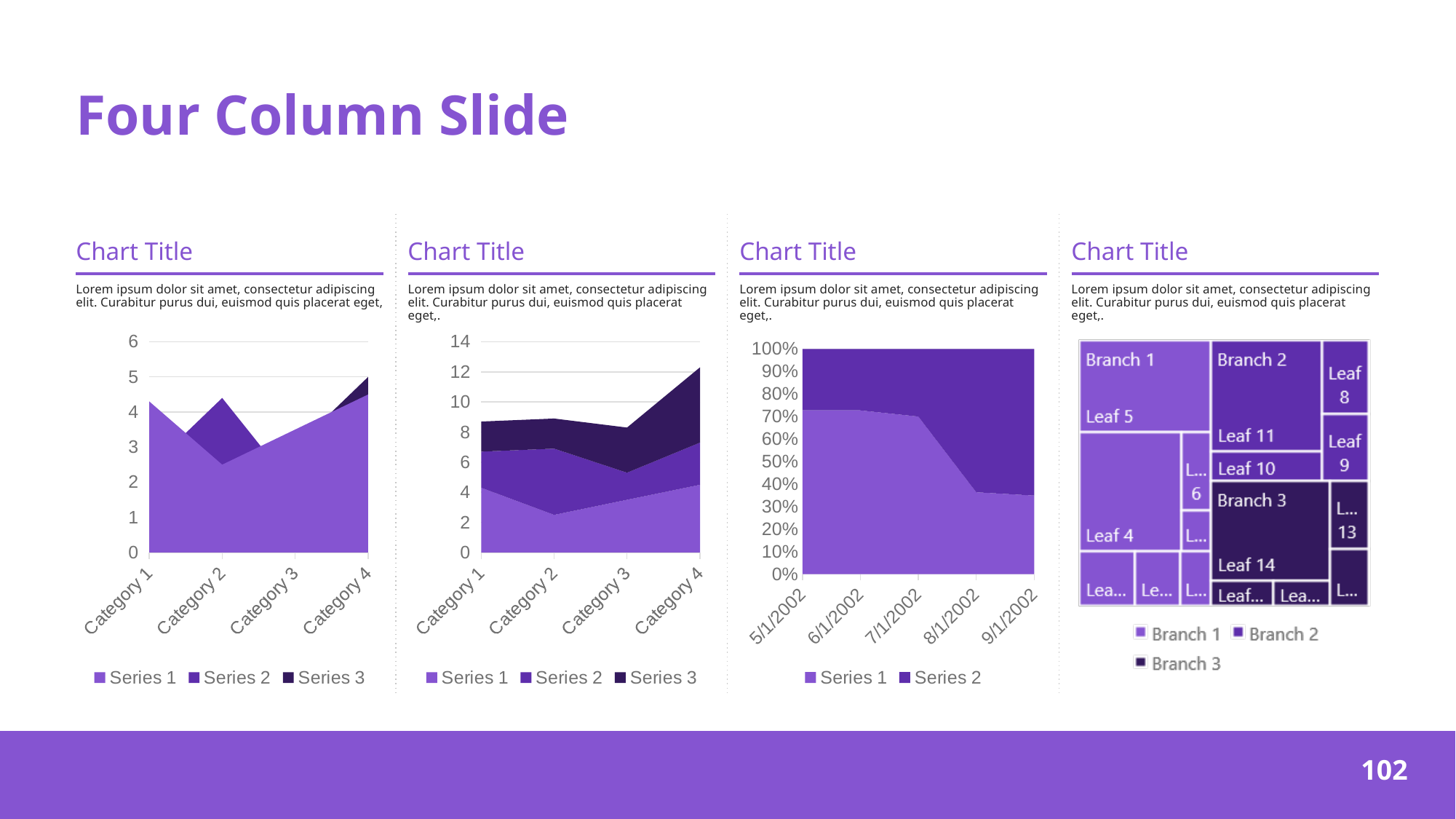
In the third chart from the left, does the share of Series 1 rise or fall from 5/1/2002 to 9/1/2002? fall How many dates are shown on the x axis of the third chart from the left? 5 In the leftmost chart, which category has the lowest value for Series 1? Category 2 How many series does the legend of the third chart from the left list? 2 How many series does the legend of the leftmost chart list? 3 In the third chart from the left, is the share of Series 1 at 9/1/2002 greater or less than 50%? less In the second chart from the left, is the stacked total at Category 4 greater or less than 10? greater What kind of chart is the leftmost chart on the slide? Area chart What are the legend entries of the rightmost chart? Branch 1, Branch 2, Branch 3 How many series does the legend of the second chart from the left list? 3 In the leftmost chart, is the value of Series 1 at Category 2 greater or less than 3? less How many categories are shown on the x axis of the leftmost chart? 4